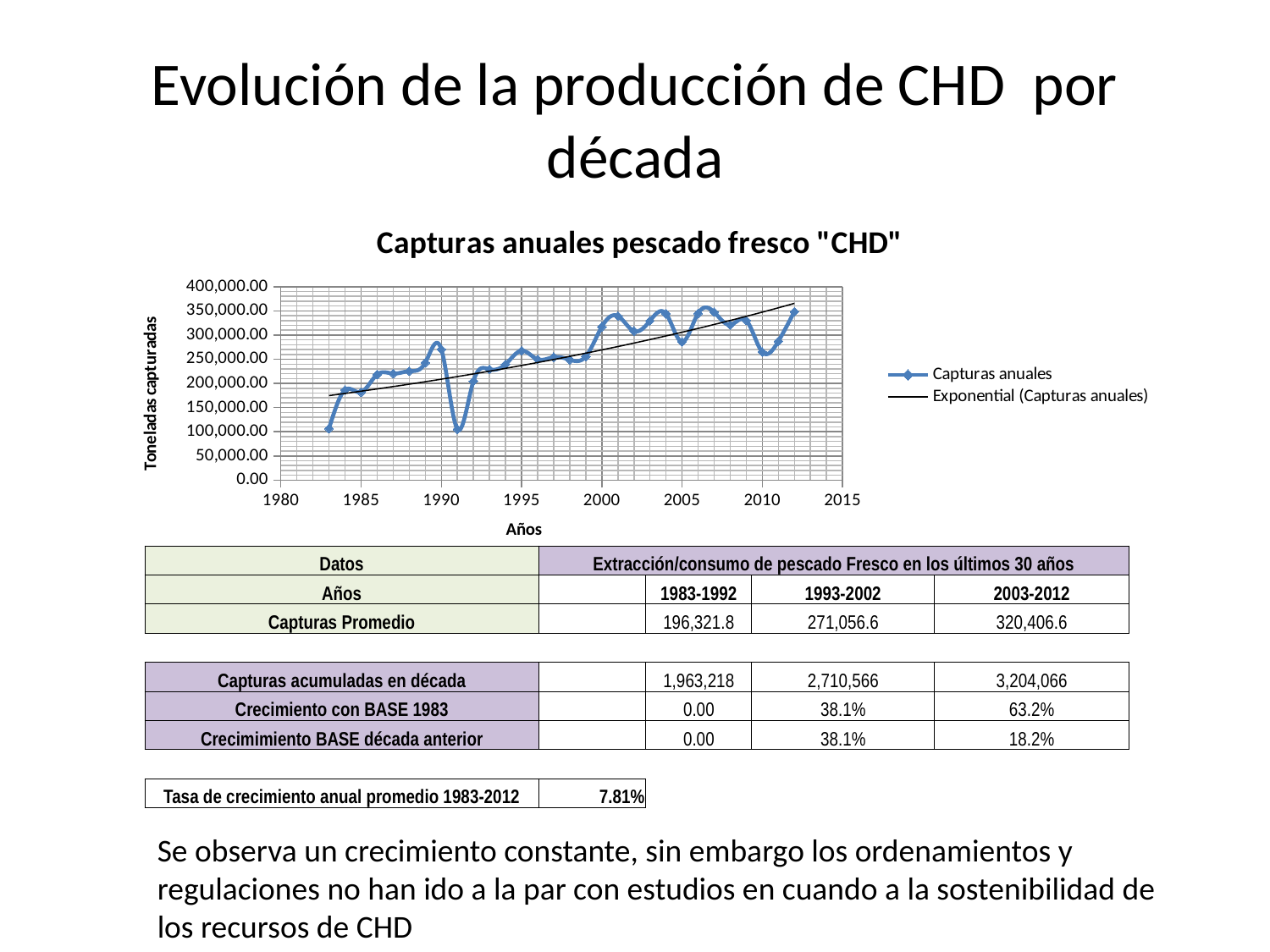
Is the value for Capturas anuales in 1992 greater or less than 150,000.00? greater Which year has the larger value for Capturas anuales, 1983 or 2012? 2012 What kind of chart is shown on the slide? line chart Is the value for Capturas anuales in 1989 greater or less than 200,000.00? greater Is the value for Capturas anuales in 1983 greater or less than 150,000.00? less How many entries does the chart legend list? 2 Which year has the larger value for Capturas anuales, 1989 or 1992? 1989 What is the label of the vertical axis of the chart? Toneladas capturadas What is the title of the chart? Capturas anuales pescado fresco "CHD" Overall, do the annual catches rise or fall from 1983 to 2012? rise